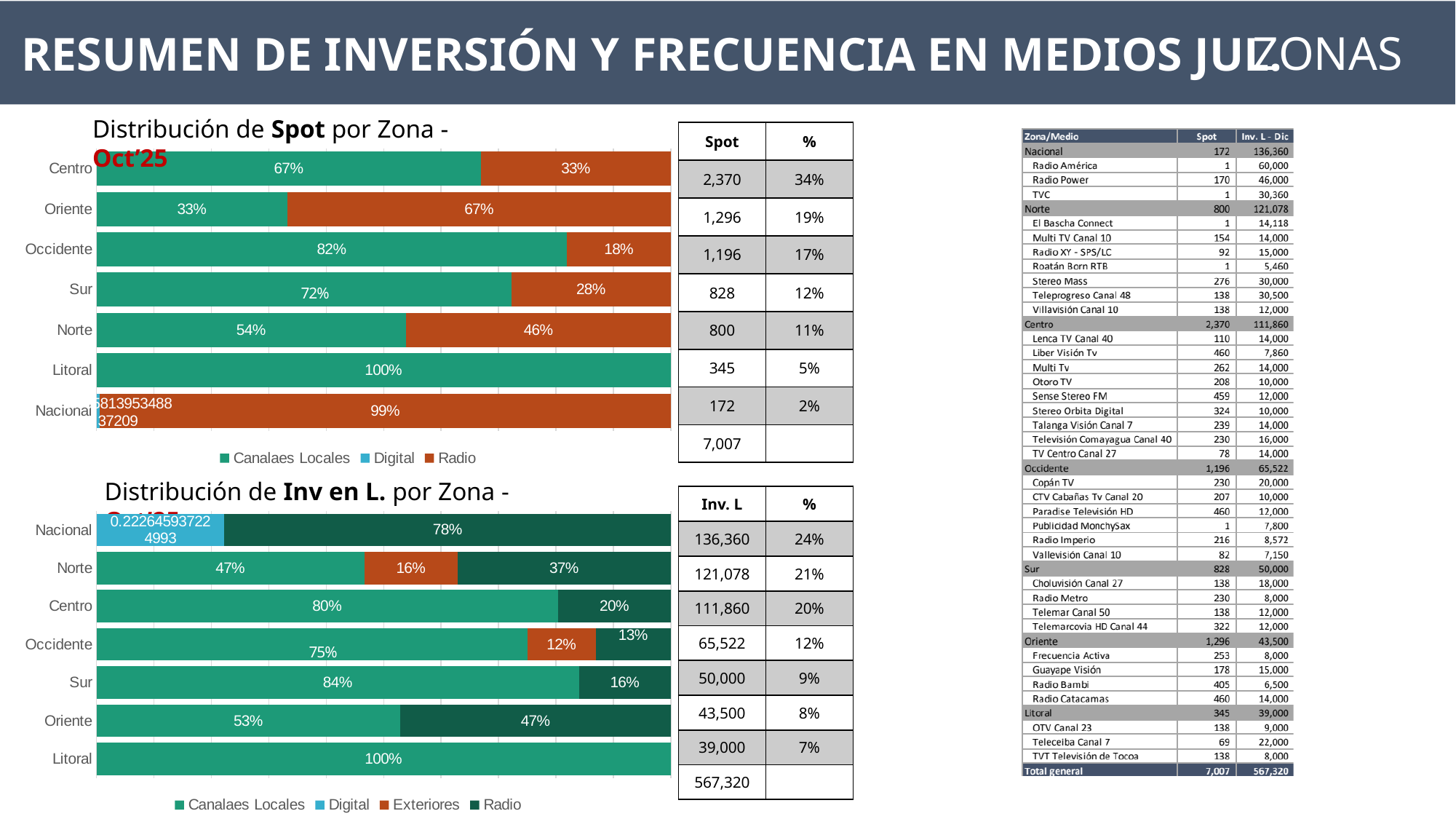
In the 'Distribución de Spot por Zona' chart, how many zones are shown? 7 In the 'Distribución de Inv en L. por Zona' chart, which zone has the highest Canalaes Locales share? Litoral What kind of chart is the 'Distribución de Inv en L. por Zona' chart? Stacked bar chart In the 'Distribución de Spot por Zona' chart, what is the Radio share for Norte? 46% In the 'Distribución de Inv en L. por Zona' chart, is the Canalaes Locales share larger for Sur or for Occidente? Sur In the 'Distribución de Inv en L. por Zona' chart, what is the Exteriores share for Norte? 16% In the 'Distribución de Spot por Zona' chart, which zone has the highest Radio share? Nacional In the 'Distribución de Spot por Zona' chart, what is the Radio share for Nacional? 99% In the 'Distribución de Inv en L. por Zona' chart, what is the Radio share for Oriente? 47% In the 'Distribución de Spot por Zona' chart, what is the difference between the Canalaes Locales share and the Radio share for Sur? 44% In the 'Distribución de Spot por Zona' chart, what is the Canalaes Locales share for Occidente? 82% In the 'Distribución de Spot por Zona' chart, how many series does the legend list? 3